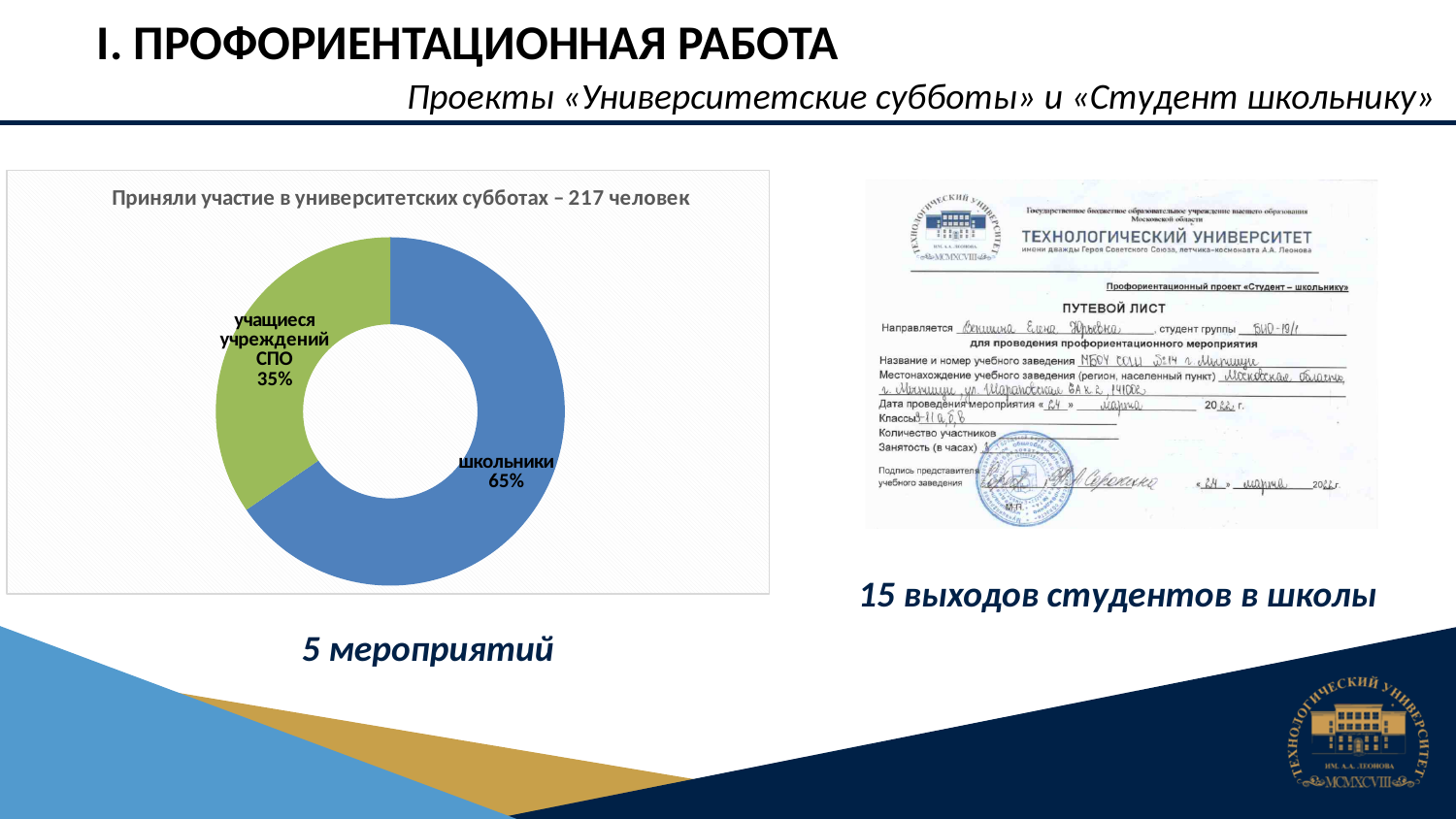
What kind of chart is shown on the slide? Doughnut (pie) chart Which category has the smallest share in the chart? учащиеся учреждений СПО By how many percentage points does the share of «школьники» exceed the share of «учащиеся учреждений СПО»? 30 percentage points What share of the chart is labelled «учащиеся учреждений СПО»? 35% What colour is the «школьники» slice in the chart? Blue Which category has the largest share in the chart? школьники Which is larger: the share of «школьники» or the share of «учащиеся учреждений СПО»? школьники What is the title of the chart? Приняли участие в университетских субботах – 217 человек How many categories (slices) does the chart show? 2 What share of the chart is labelled «школьники»? 65% How many people in total participated in the university Saturdays according to the chart title? 217 человек